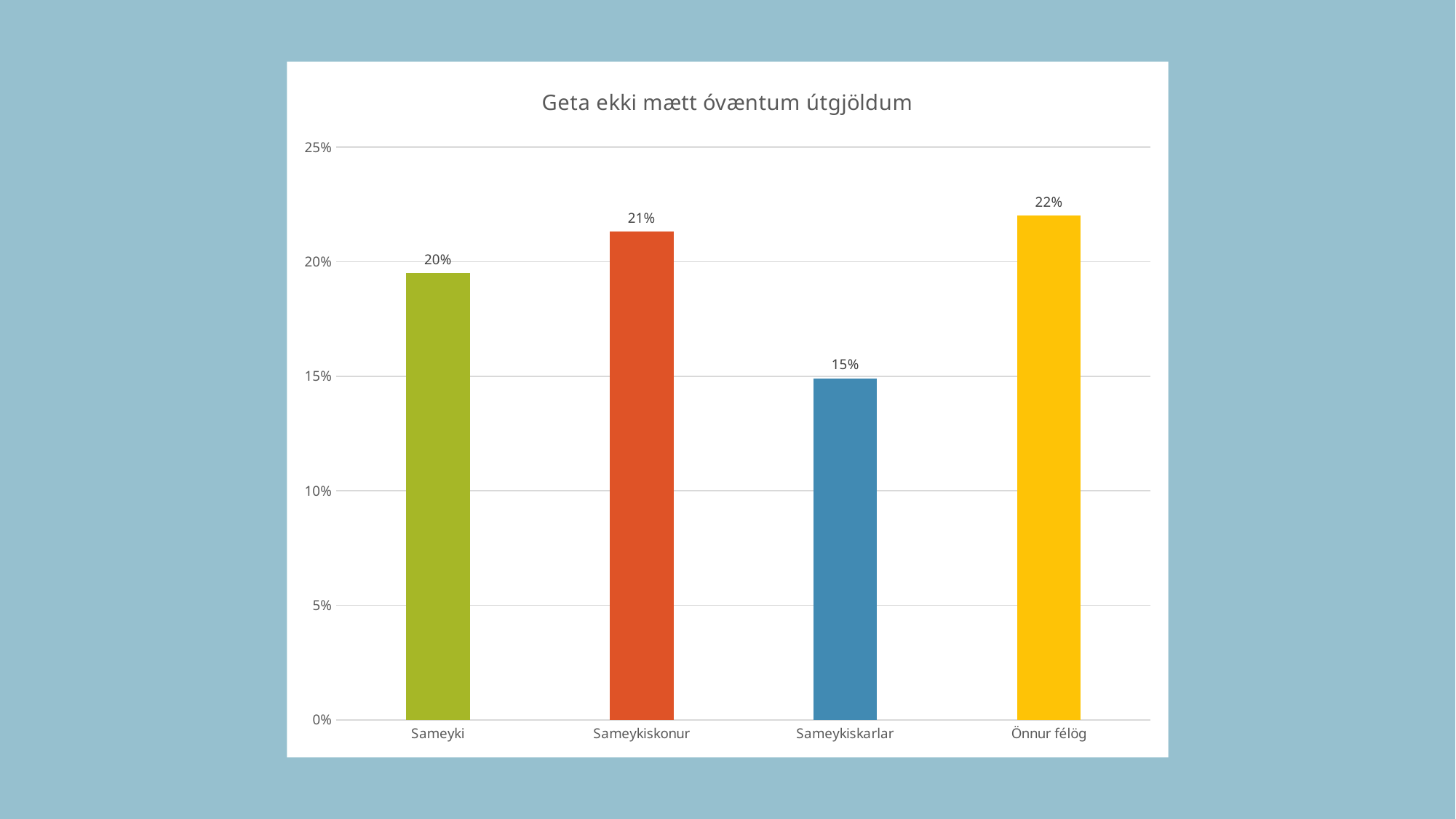
What is the difference between the values for Önnur félög and Sameykiskarlar? 7% Which is larger, the value for Sameyki or the value for Sameykiskarlar? Sameyki What is the title of the chart? Geta ekki mætt óvæntum útgjöldum What kind of chart is shown on the slide? Bar chart What is the value for Sameykiskarlar? 15% How many categories are shown on the chart? 4 Which category has the highest value? Önnur félög Which category has the lowest value? Sameykiskarlar What is the value for Sameykiskonur? 21% What is the value for Önnur félög? 22% Is the value for Sameykiskonur greater or less than 20%? greater What is the value for Sameyki? 20%